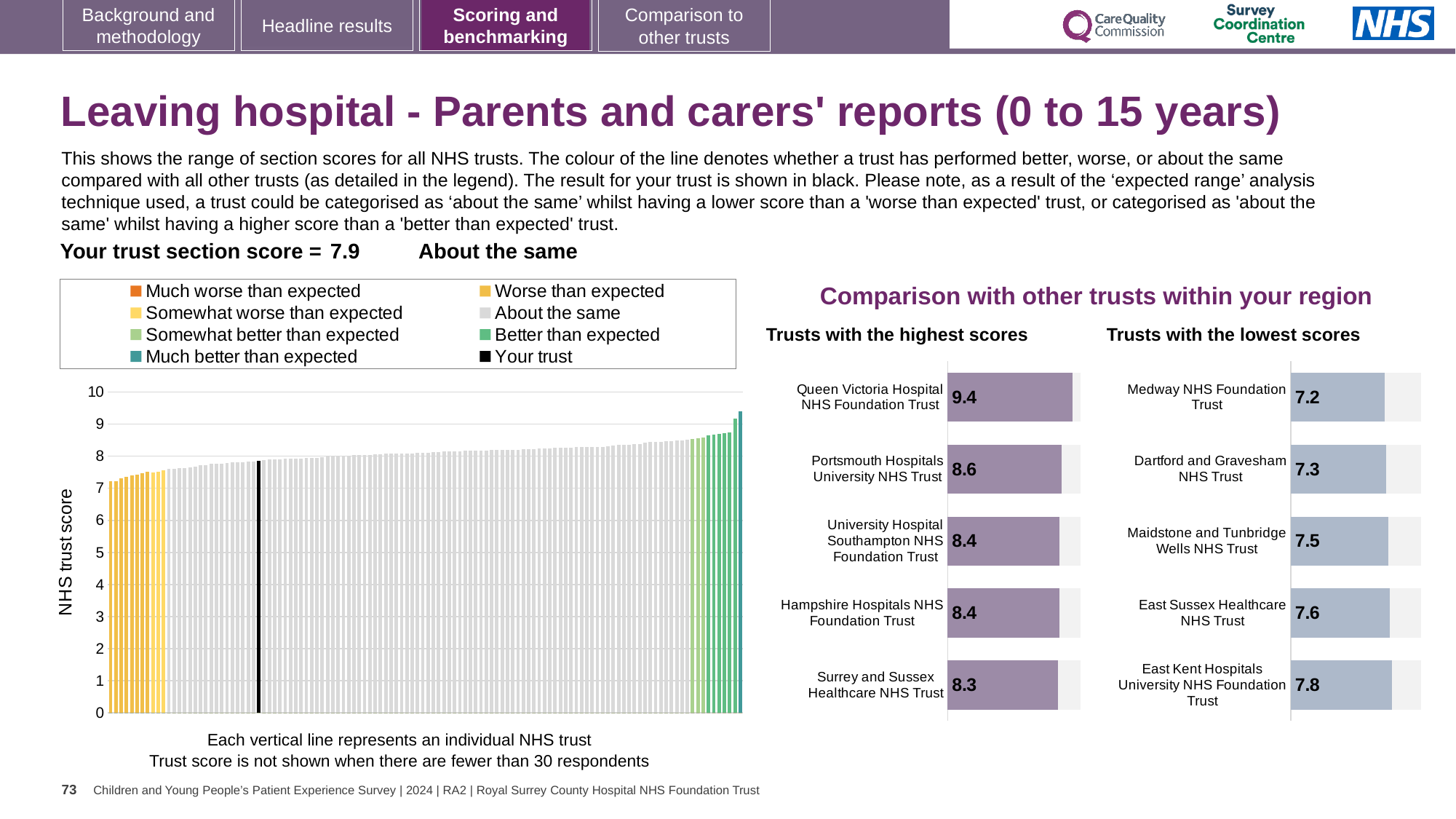
In the 'Trusts with the lowest scores' chart, what is the score for Medway NHS Foundation Trust? 7.2 In the 'Trusts with the lowest scores' chart, what is the difference between the scores of East Kent Hospitals University NHS Foundation Trust and Medway NHS Foundation Trust? 0.6 In the 'Trusts with the highest scores' chart, what is the score for Queen Victoria Hospital NHS Foundation Trust? 9.4 In the 'Trusts with the highest scores' chart, which trust has the lowest score? Surrey and Sussex Healthcare NHS Trust How many trusts are shown in the 'Trusts with the highest scores' chart? 5 In the 'NHS trust score' chart on the left, do the bars rise or fall from left to right? Rise How many entries does the legend of the 'NHS trust score' chart list? 8 In the 'NHS trust score' chart on the left, is the value of the tallest bar greater or less than 9? greater In the 'Trusts with the lowest scores' chart, which has the higher score: Dartford and Gravesham NHS Trust or Maidstone and Tunbridge Wells NHS Trust? Maidstone and Tunbridge Wells NHS Trust In the 'Trusts with the lowest scores' chart, which trust has the highest score? East Kent Hospitals University NHS Foundation Trust In the 'Trusts with the highest scores' chart, what is the difference between the scores of Queen Victoria Hospital NHS Foundation Trust and Surrey and Sussex Healthcare NHS Trust? 1.1 What kind of chart is the 'NHS trust score' chart on the left? Bar chart